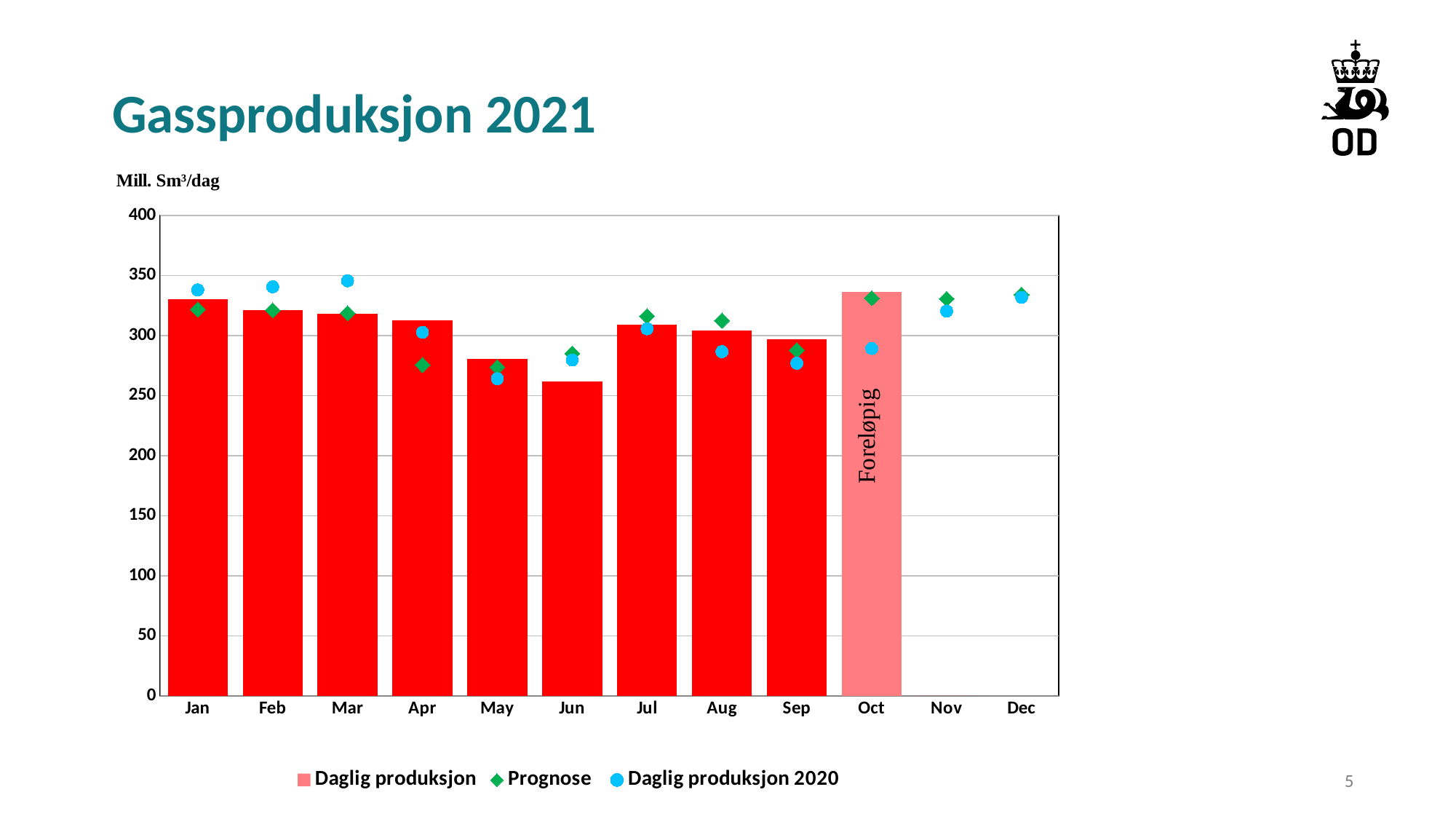
How many months are shown on the x axis? 12 Is the Daglig produksjon 2020 value for Oct greater or less than 300? less How many months have a Daglig produksjon bar plotted? 10 Which month has the lowest Daglig produksjon bar? Jun Is the Daglig produksjon value for Jun greater or less than 300? less Is the Daglig produksjon 2020 value for Mar greater or less than 300? greater Do the Daglig produksjon bars rise or fall from Jan to Jun? fall Which is larger, the Daglig produksjon bar for May or for Jun? May What kind of chart is shown on the slide? Bar chart (with point markers) How many series does the legend list? 3 What word is written on the lighter-coloured Oct bar? Foreløpig